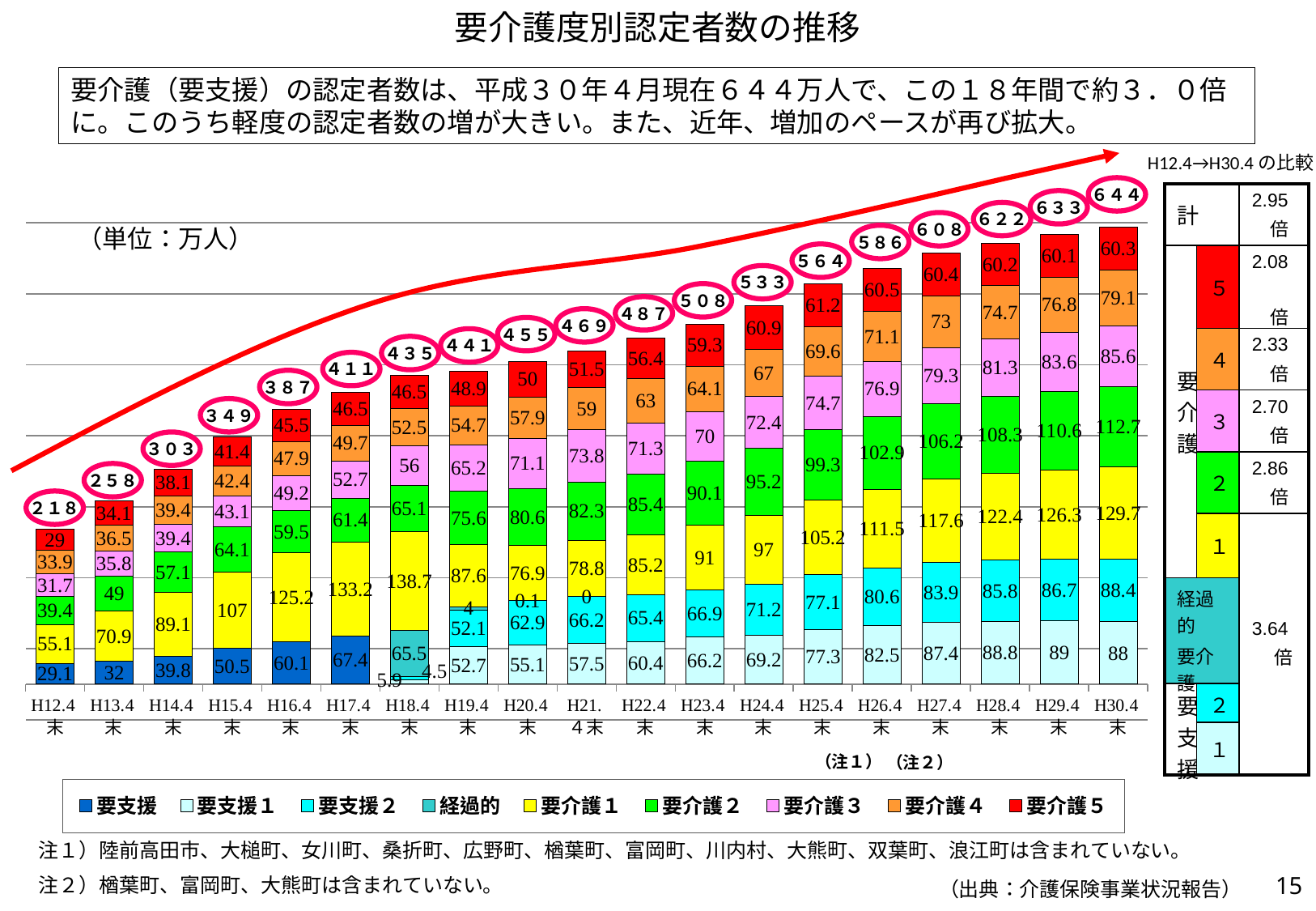
In H30.4末, which is larger, 要介護2 or 要介護3? 要介護2 What is the difference between the total for H30.4末 and the total for H12.4末? 426 What is the value for 要介護1 in H30.4末? 129.7 How many bars (time points) are plotted along the x axis? 19 How many series does the legend list? 9 What is the value for 要支援1 in H25.4末? 77.3 What is the value for 要介護5 in H12.4末? 29 Do the bar totals rise or fall from H12.4末 to H30.4末? rise What is the total of the stacked bar for H30.4末? 644 What kind of chart is shown on the slide? bar chart Which time point has the highest total number of certified persons? H30.4末 Which time point has the lowest total number of certified persons? H12.4末